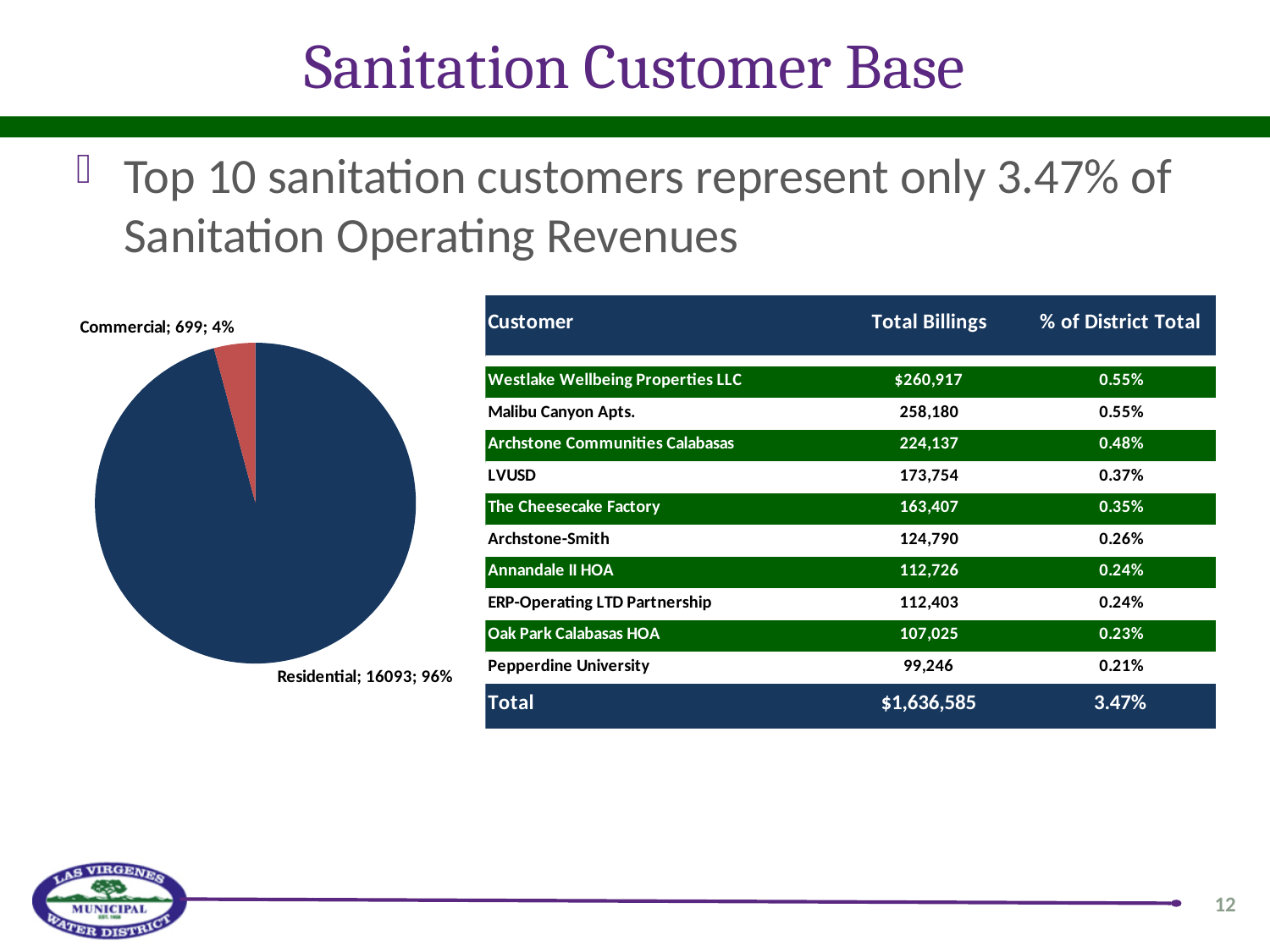
Which category has the largest slice in the pie chart? Residential What colour is the Commercial slice in the pie chart? red What is the total of the two values shown in the pie chart? 16792 What is the value for Commercial in the pie chart? 699 What is the difference between the Residential and Commercial values in the pie chart? 15394 What kind of chart is shown on the left of the slide? pie chart What share of the pie does the Residential slice represent? 96% What is the value for Residential in the pie chart? 16093 Which is larger in the pie chart, Commercial or Residential? Residential How many slices does the pie chart have? 2 What share of the pie does the Commercial slice represent? 4% Which category has the smallest slice in the pie chart? Commercial